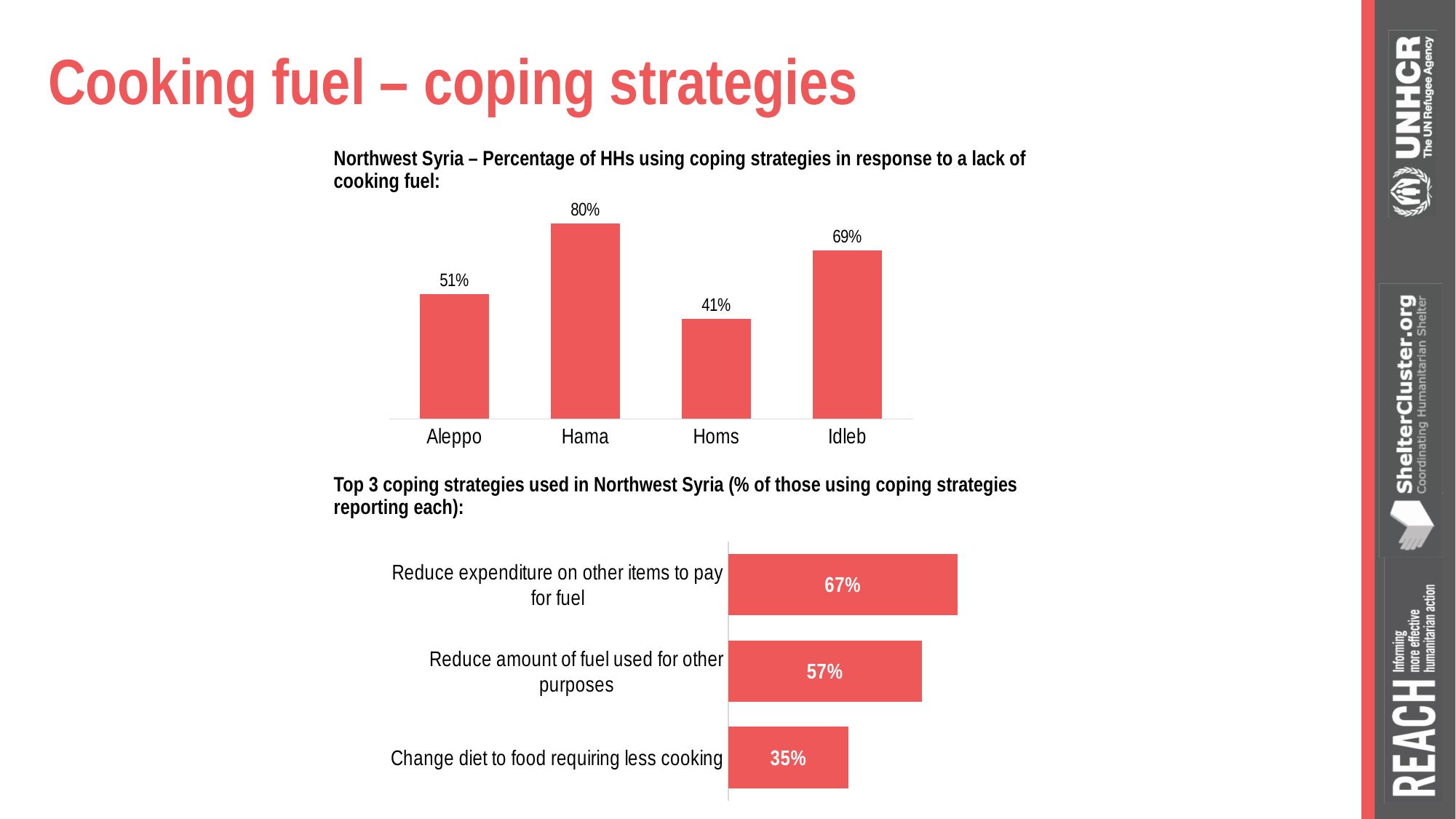
In the bottom chart (Top 3 coping strategies), which strategy has the highest value? Reduce expenditure on other items to pay for fuel In the top chart (Percentage of HHs using coping strategies), what is the value for Homs? 41% In the bottom chart (Top 3 coping strategies), what is the difference between 'Reduce expenditure on other items to pay for fuel' and 'Reduce amount of fuel used for other purposes'? 10% In the top chart (Percentage of HHs using coping strategies), which governorate has the lowest value? Homs In the bottom chart (Top 3 coping strategies), how many strategies are shown? 3 In the bottom chart (Top 3 coping strategies), what is the value for 'Change diet to food requiring less cooking'? 35% In the top chart (Percentage of HHs using coping strategies), which is larger, Aleppo or Idleb? Idleb In the top chart (Percentage of HHs using coping strategies), what is the difference between Idleb and Aleppo? 18% What kind of chart is the top chart (Percentage of HHs using coping strategies)? Bar chart In the top chart (Percentage of HHs using coping strategies), which governorate has the highest value? Hama In the top chart (Percentage of HHs using coping strategies), what is the value for Hama? 80% In the top chart (Percentage of HHs using coping strategies), how many governorates are shown? 4